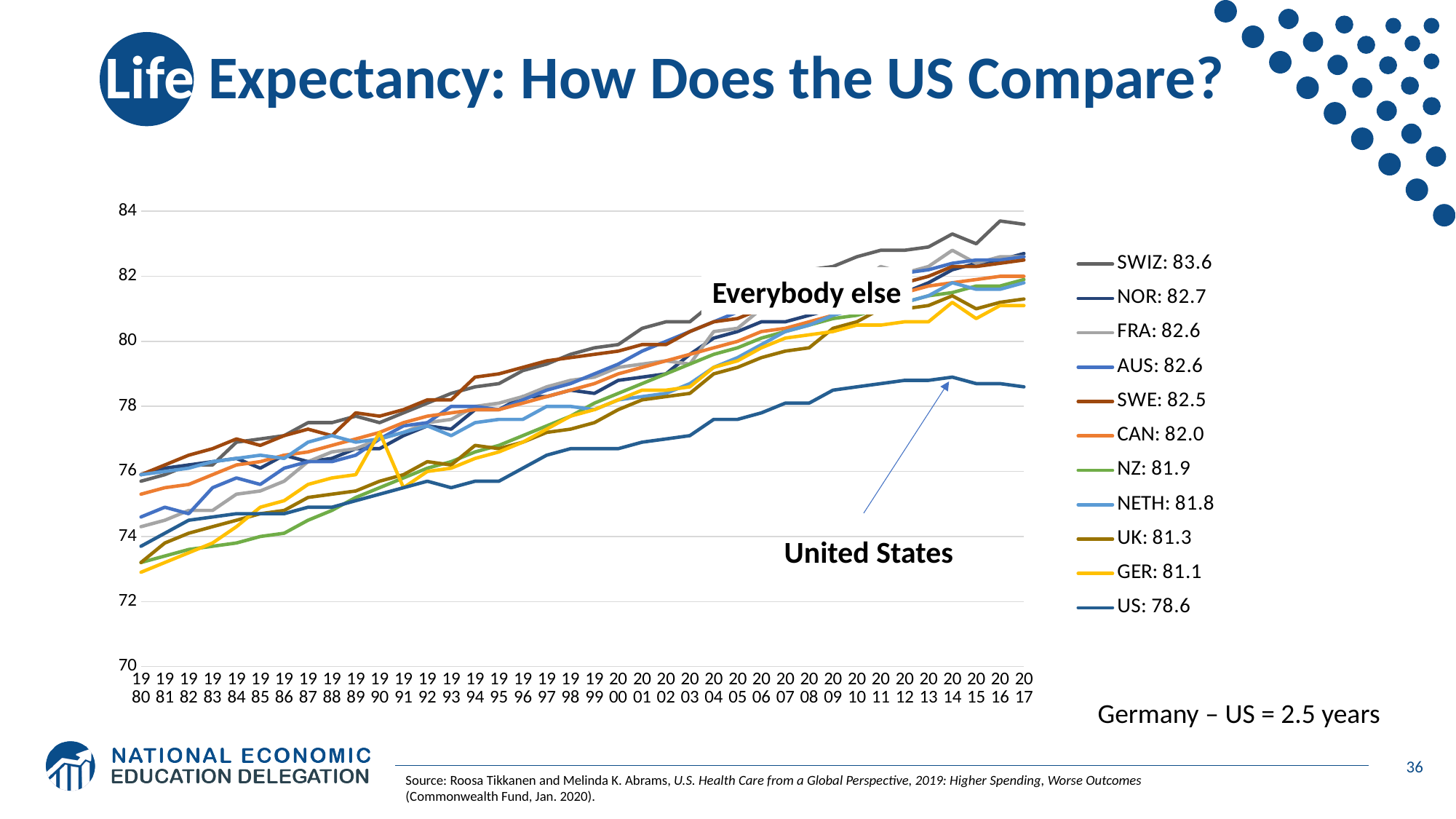
Do the life expectancy lines generally rise or fall from 1980 to 2017? rise Which country has the lowest life expectancy value in the legend? US What kind of chart is shown on the slide? line chart Is the value for the US in 2017 greater or less than 80? less What is the difference between the legend values for GER and the US? 2.5 Which country has the highest life expectancy value in the legend? SWIZ According to the legend, what is the life expectancy value shown for the US? 78.6 Which has the higher legend value, NOR or SWE? NOR According to the legend, what is the life expectancy value shown for SWIZ? 83.6 How many years are shown on the x axis? 38 How many countries (series) does the legend list? 11 What label is used on the chart for the group of lines above the United States line? Everybody else